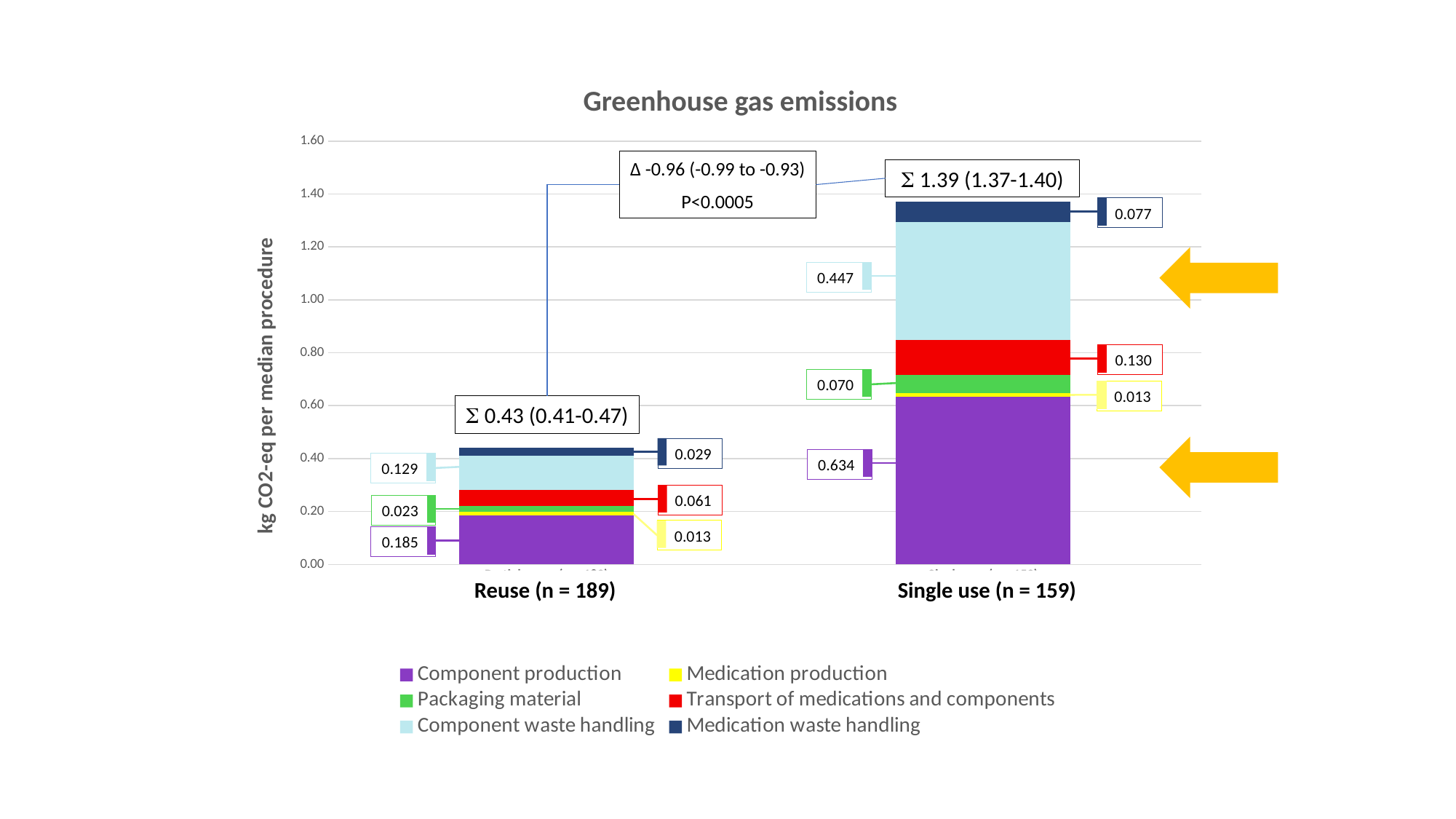
What is the Component production value for Single use (n = 159)? 0.634 How many categories are shown on the x axis? 2 What kind of chart is shown on the slide? Stacked bar chart What is the difference between the Component production values for Single use (n = 159) and Reuse (n = 189)? 0.449 What is the Transport of medications and components value for Single use (n = 159)? 0.130 How many series does the legend list? 6 What is the total (Σ) shown for the Single use (n = 159) bar? 1.39 (1.37-1.40) What is the Medication waste handling value for Reuse (n = 189)? 0.029 What is the title of the chart? Greenhouse gas emissions Which category has the higher Packaging material value, Reuse (n = 189) or Single use (n = 159)? Single use (n = 159) What is the Component waste handling value for Reuse (n = 189)? 0.129 Is the total height of the Reuse (n = 189) bar greater or less than 0.60? less